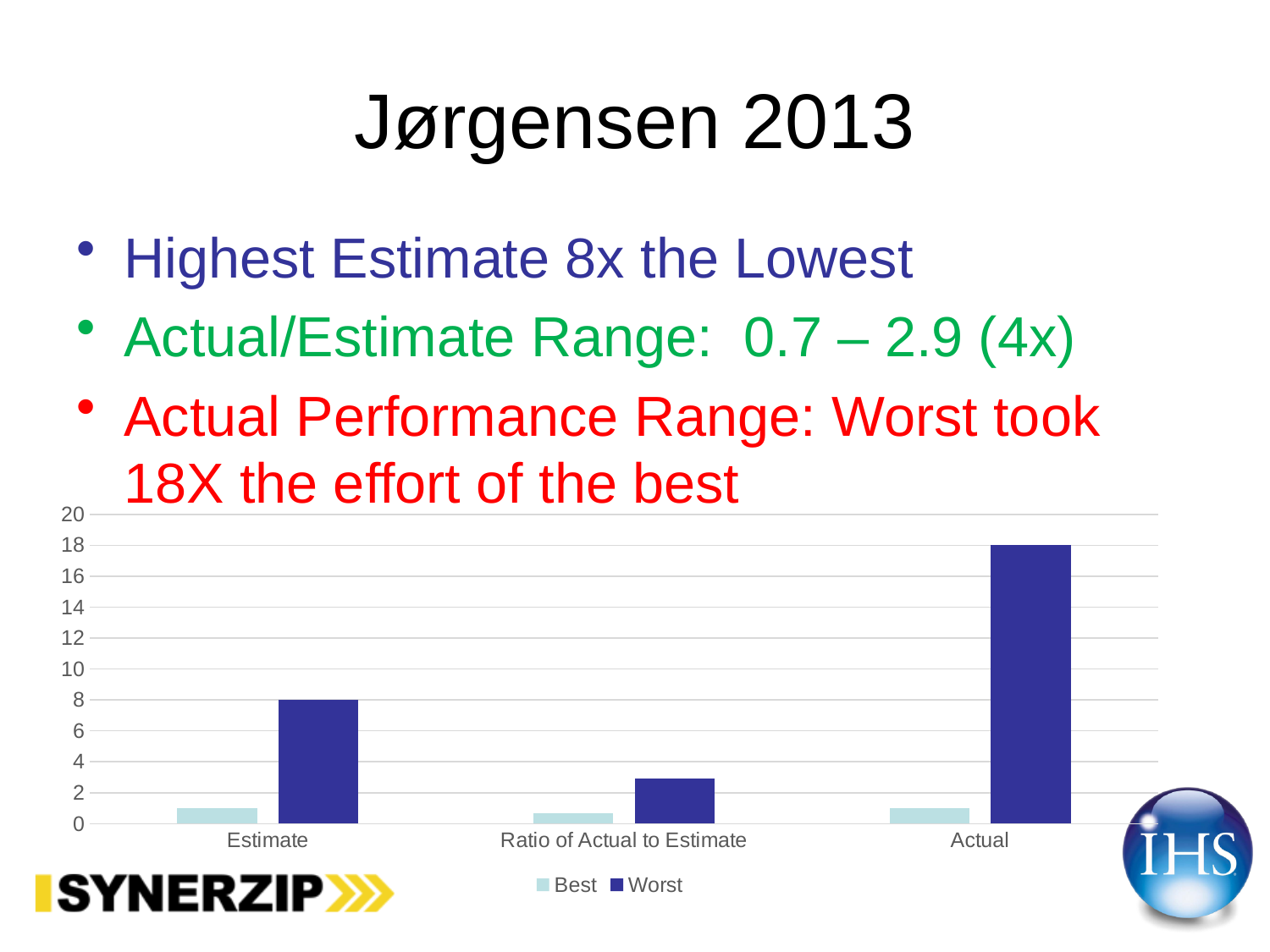
What is the difference between the Worst value for Actual and the Worst value for Estimate? 10 Which category has the lowest Worst value? Ratio of Actual to Estimate Is the Worst value for Ratio of Actual to Estimate greater or less than 4? less What kind of chart is shown on the slide? bar chart Which is larger, the Worst value for Estimate or the Worst value for Actual? Actual What are the two series names listed in the chart legend? Best and Worst Is the Best value for Estimate greater or less than 2? less Which category has the highest Worst value? Actual What is the Worst value for Estimate? 8 How many series does the chart legend list? 2 How many categories are shown on the x axis of the chart? 3 What is the Worst value for Actual? 18